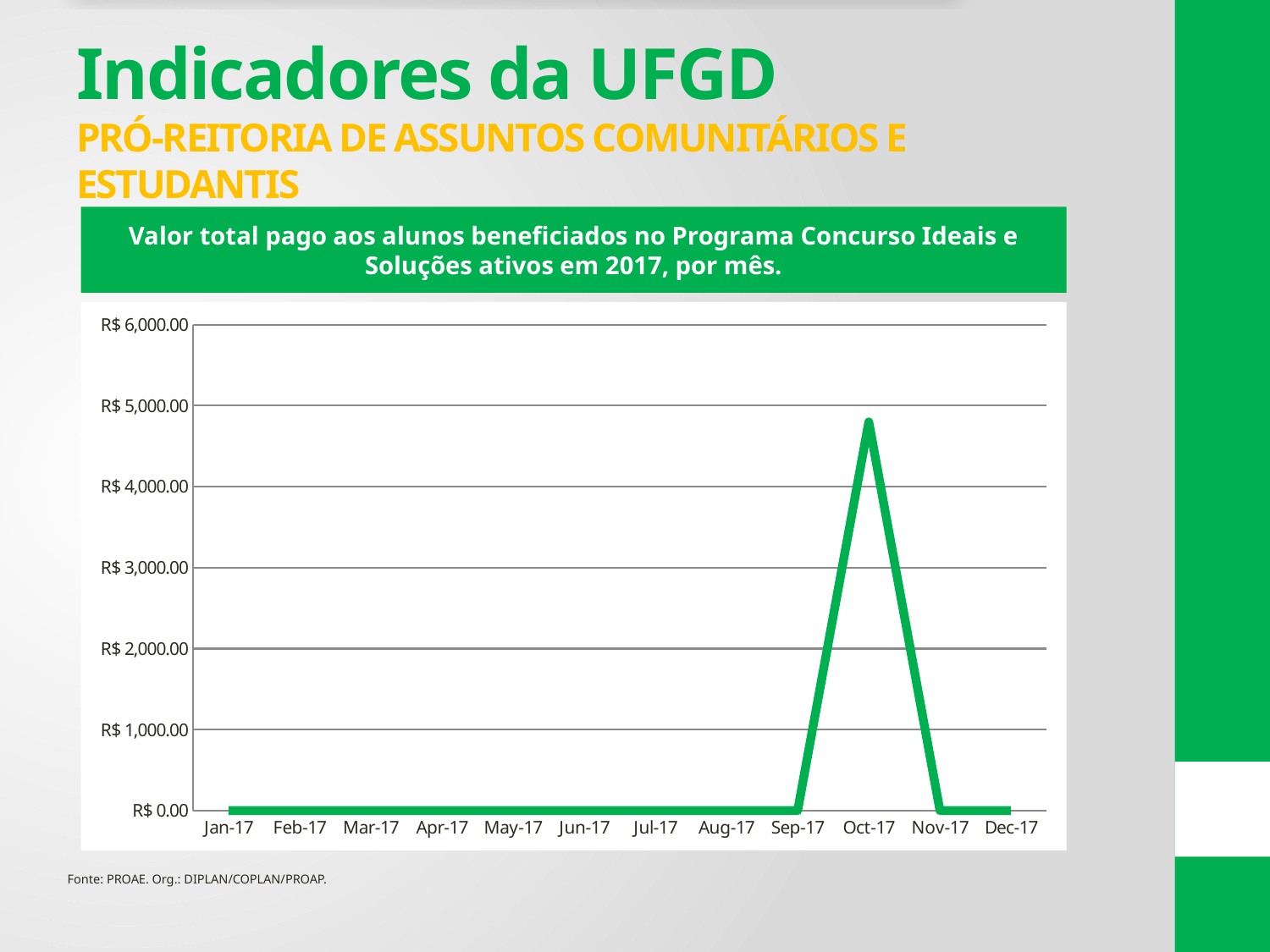
What kind of chart is shown on the slide? line chart What is the value paid in Jan-17? R$ 0.00 Is the value for Oct-17 greater or less than R$ 5,000.00? less Which month has the highest value paid? Oct-17 What is the title of the chart? Valor total pago aos alunos beneficiados no Programa Concurso Ideais e Soluções ativos em 2017, por mês. What is the value paid in Nov-17? R$ 0.00 Does the value rise or fall from Oct-17 to Nov-17? fall Which is larger, the value for Oct-17 or the value for Sep-17? Oct-17 How many months are plotted along the x axis? 12 What is the value paid in Dec-17? R$ 0.00 What is the highest value shown on the y axis? R$ 6,000.00 Is the value for Oct-17 greater or less than R$ 4,000.00? greater